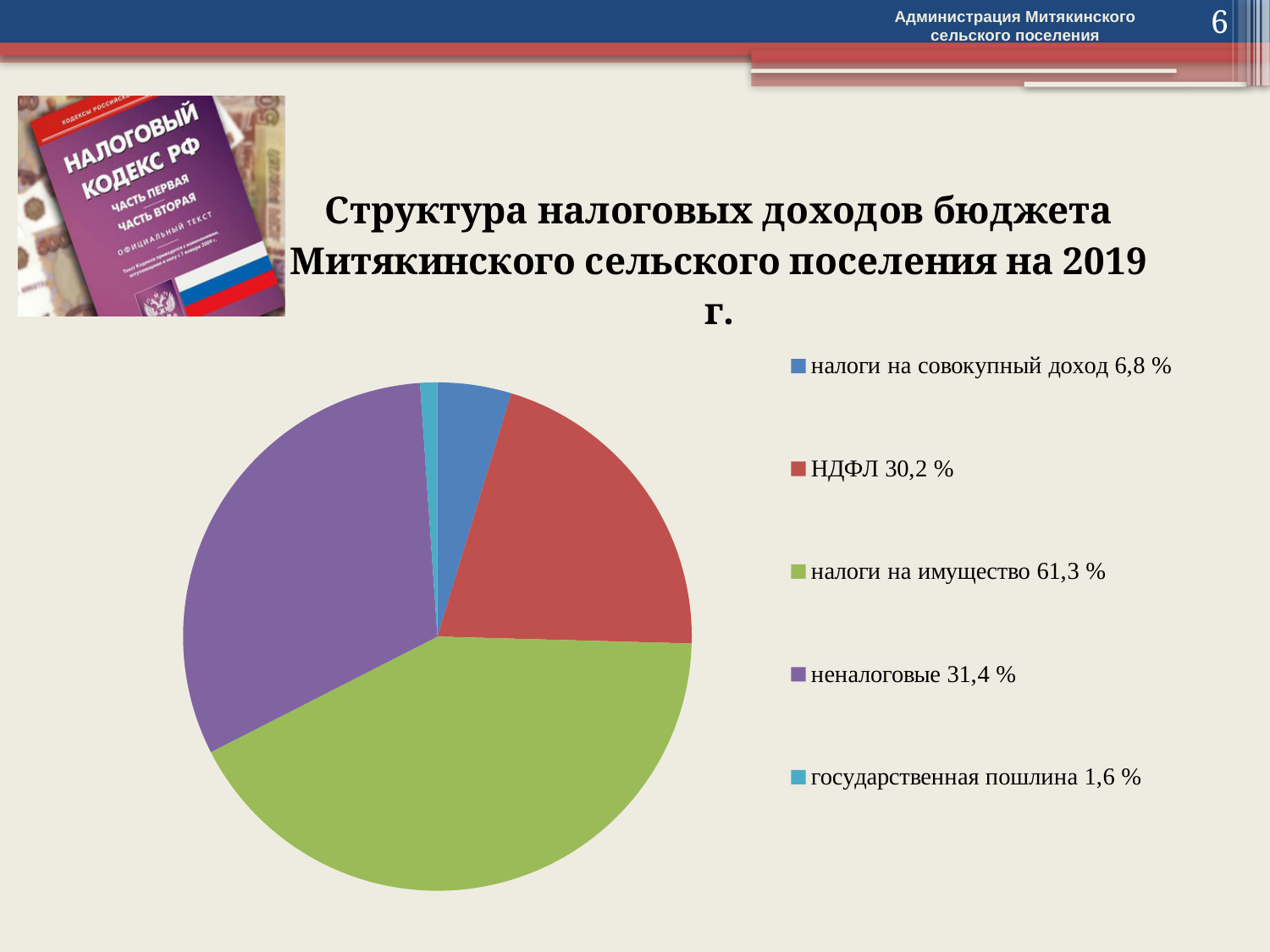
What kind of chart is shown on the slide? pie chart What colour is the slice for налоги на имущество? green What is the value shown for неналоговые? 31,4 % Which is larger, налоги на совокупный доход or НДФЛ? НДФЛ What is the value shown for НДФЛ? 30,2 % How many categories does the pie chart show? 5 What is the difference between the values for налоги на имущество and НДФЛ? 31,1 % What is the value shown for налоги на имущество? 61,3 % What is the value shown for налоги на совокупный доход? 6,8 % What is the value shown for государственная пошлина? 1,6 % Which category has the largest share of the pie? налоги на имущество Which category has the smallest share of the pie? государственная пошлина